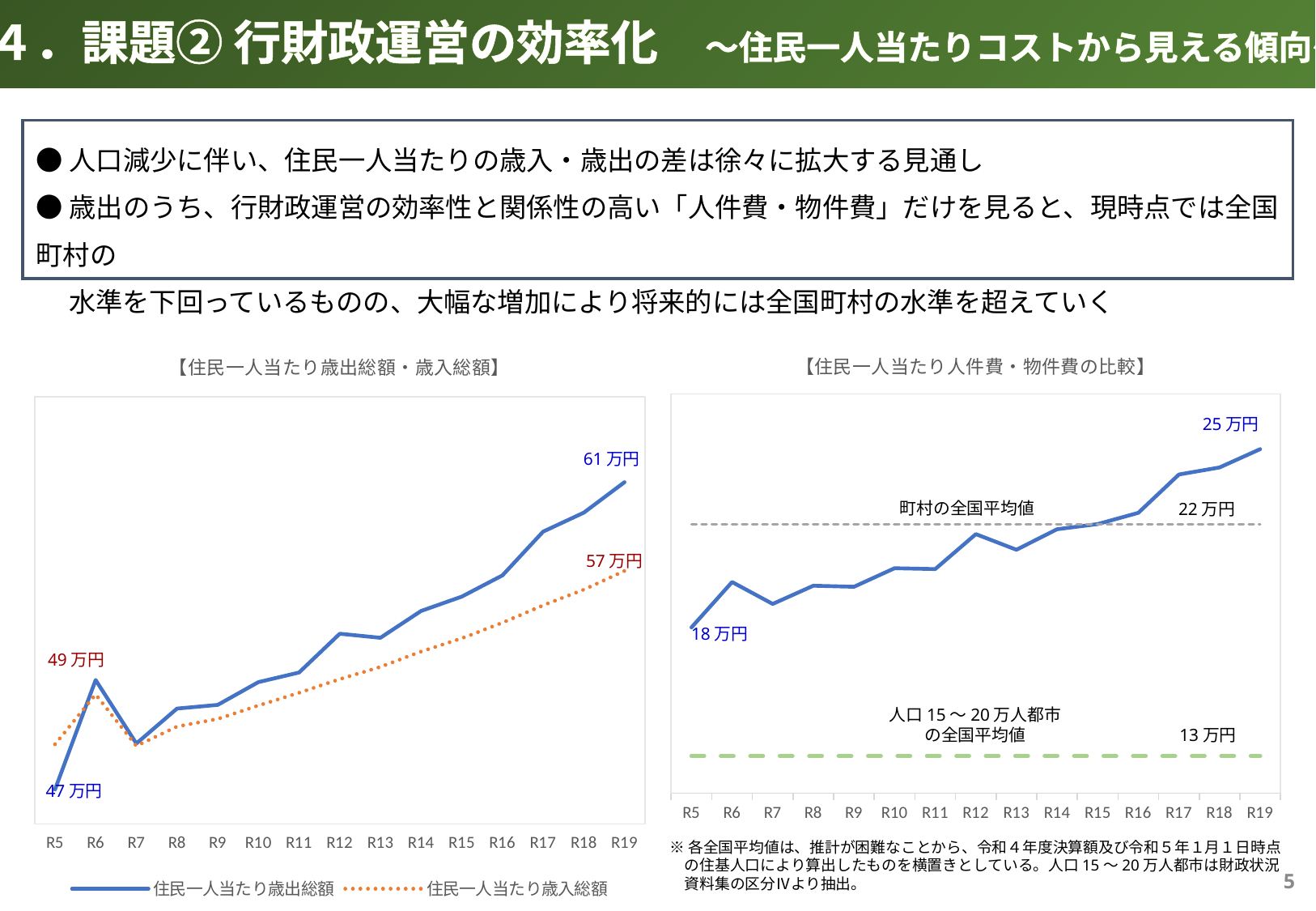
In the right chart 【住民一人当たり人件費・物件費の比較】, what is the value at R5? 18 万円 In the left chart 【住民一人当たり歳出総額・歳入総額】, what is the value of 住民一人当たり歳入総額 at R19? 57 万円 In the right chart 【住民一人当たり人件費・物件費の比較】, what is the value at R19? 25 万円 What kind of chart is the left chart titled 【住民一人当たり歳出総額・歳入総額】? line chart In the left chart 【住民一人当たり歳出総額・歳入総額】, what is the value of 住民一人当たり歳出総額 at R5? 47 万円 In the right chart 【住民一人当たり人件費・物件費の比較】, what is the difference between 町村の全国平均値 and 人口15～20万人都市の全国平均値? 9 万円 In the left chart 【住民一人当たり歳出総額・歳入総額】, what is the value of 住民一人当たり歳出総額 at R19? 61 万円 How many series does the legend of the left chart 【住民一人当たり歳出総額・歳入総額】 list? 2 In the left chart 【住民一人当たり歳出総額・歳入総額】, what is the difference between 歳出総額 and 歳入総額 at R19? 4 万円 How many years are shown on the x axis of the left chart 【住民一人当たり歳出総額・歳入総額】? 15 In the right chart 【住民一人当たり人件費・物件費の比較】, what is the 町村の全国平均値? 22 万円 In the left chart 【住民一人当たり歳出総額・歳入総額】, does 住民一人当たり歳出総額 generally rise or fall from R7 to R19? rise